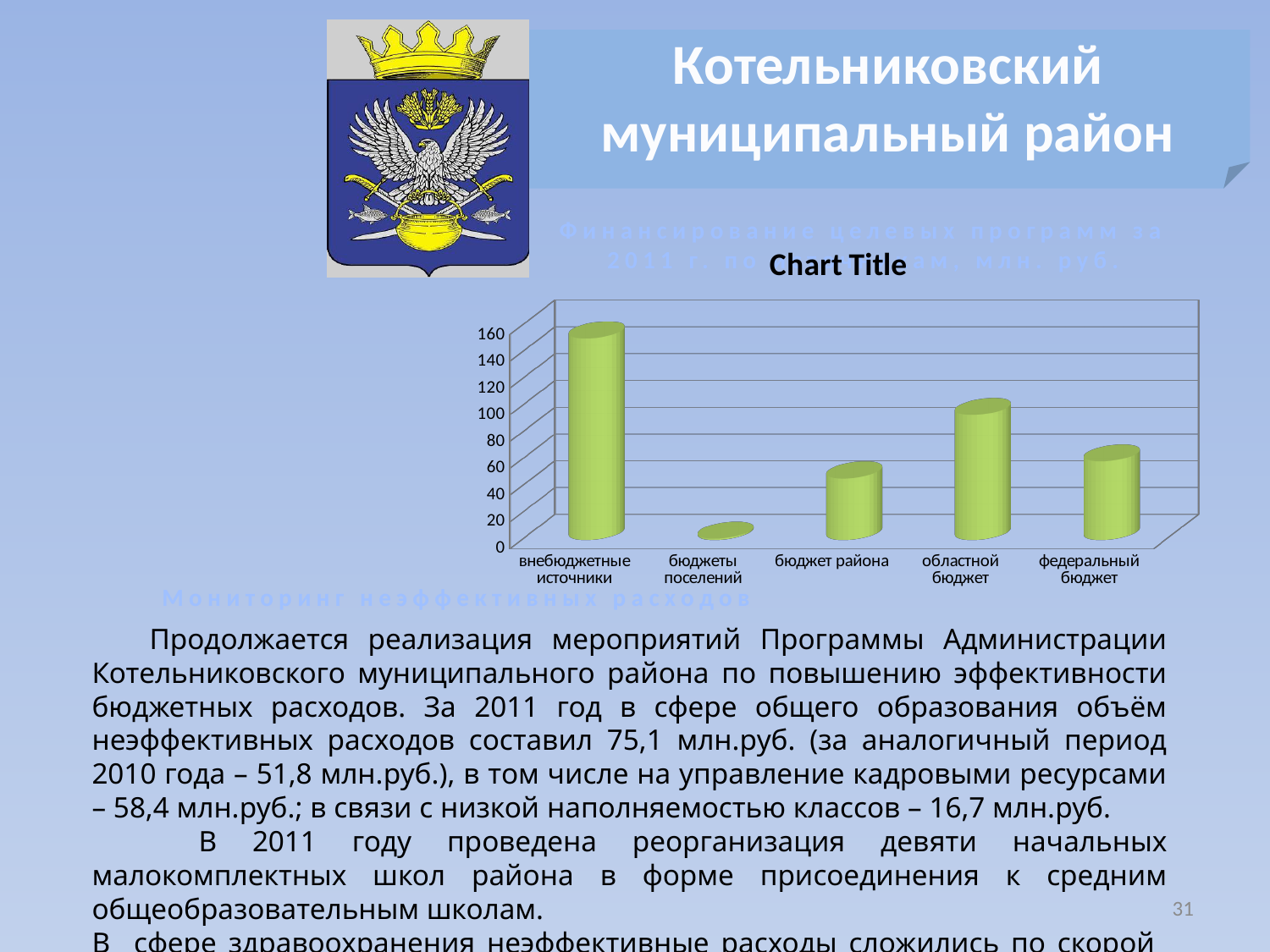
Which category has the highest bar in the chart? внебюджетные источники Is the value for областной бюджет greater or less than 60? greater Is the value for внебюджетные источники greater or less than 120? greater How many categories are shown on the x axis of the chart? 5 Which category has the lowest bar in the chart? бюджеты поселений Which is larger, the value for бюджет района or the value for областной бюджет? областной бюджет What kind of chart is shown on the slide? bar chart Is the value for бюджет района greater or less than 80? less What is the title printed above the chart? Chart Title Which is larger, the value for областной бюджет or the value for федеральный бюджет? областной бюджет